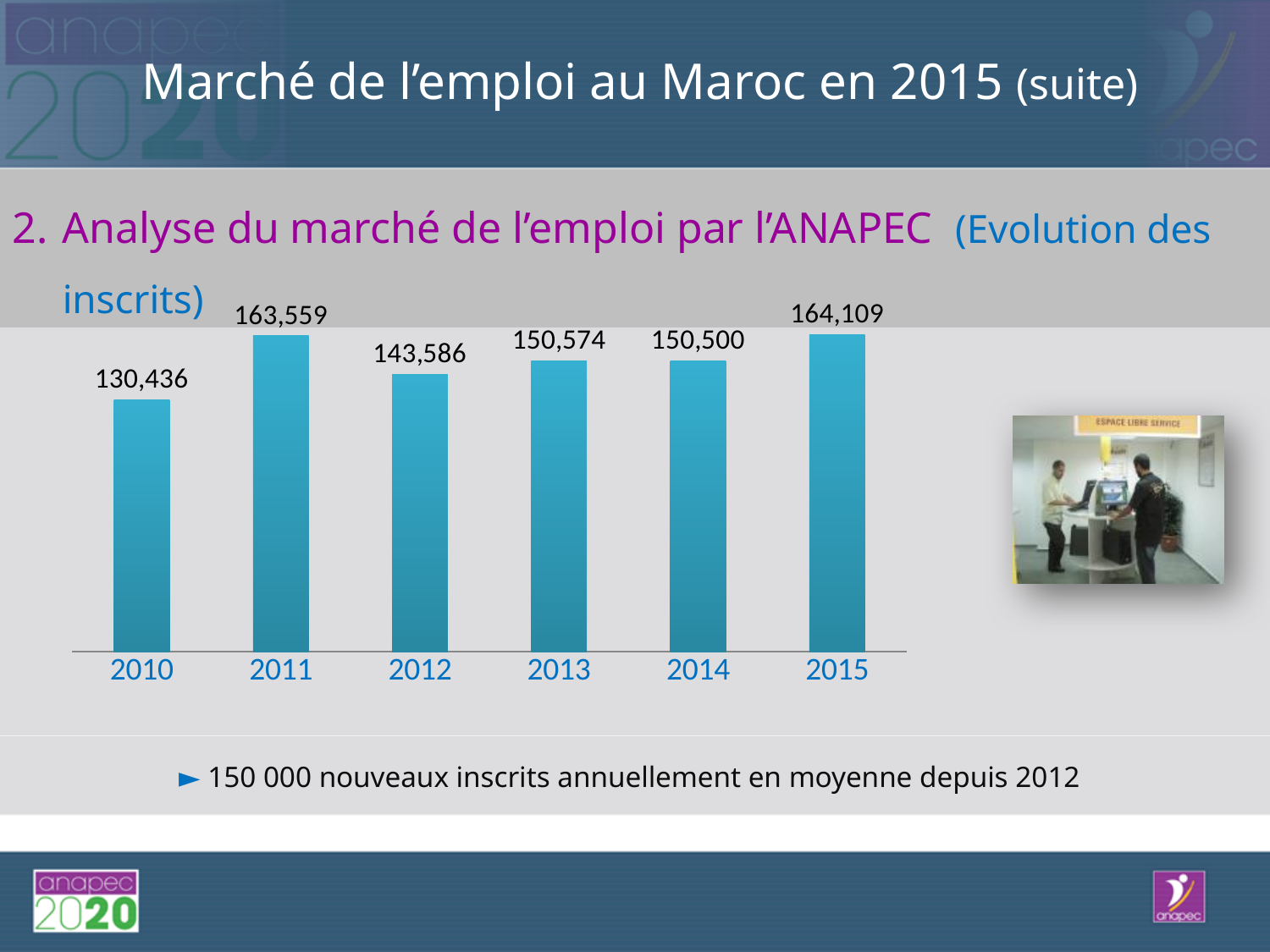
Which is larger, the value for 2011 or the value for 2012? 2011 How many years are shown on the x axis? 6 Does the value rise or fall from 2011 to 2012? Fall What is the value shown for 2013? 150,574 What is the difference between the values for 2015 and 2010? 33,673 Which year has the highest value? 2015 Which year has the lowest value? 2010 What is the difference between the values for 2013 and 2014? 74 What is the value shown for 2010? 130,436 Which is larger, the value for 2013 or the value for 2014? 2013 What kind of chart is shown on the slide? Bar chart What is the value shown for 2015? 164,109